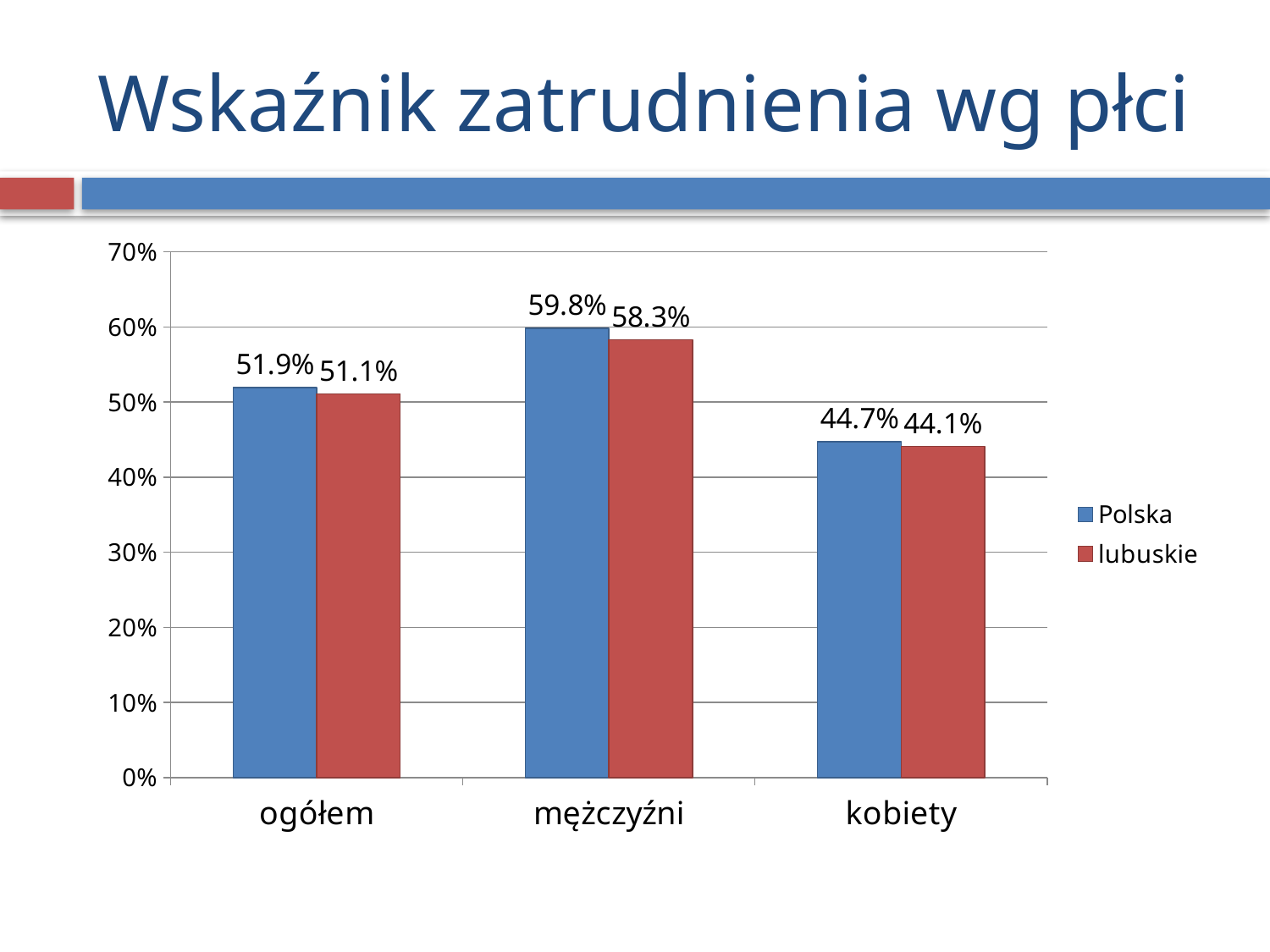
What is the value for lubuskie in the kobiety category? 44.1% How many categories are shown on the x axis? 3 What is the value for lubuskie in the ogółem category? 51.1% What is the difference between the Polska values for mężczyźni and kobiety? 15.1% Which category has the highest value for Polska? mężczyźni What kind of chart is shown on the slide? bar chart Which is larger in the ogółem category, Polska or lubuskie? Polska What is the difference between the Polska and lubuskie values in the mężczyźni category? 1.5% How many series does the legend list? 2 Is the value for lubuskie in the kobiety category greater or less than 50%? less Which category has the lowest value for lubuskie? kobiety What is the value for Polska in the mężczyźni category? 59.8%